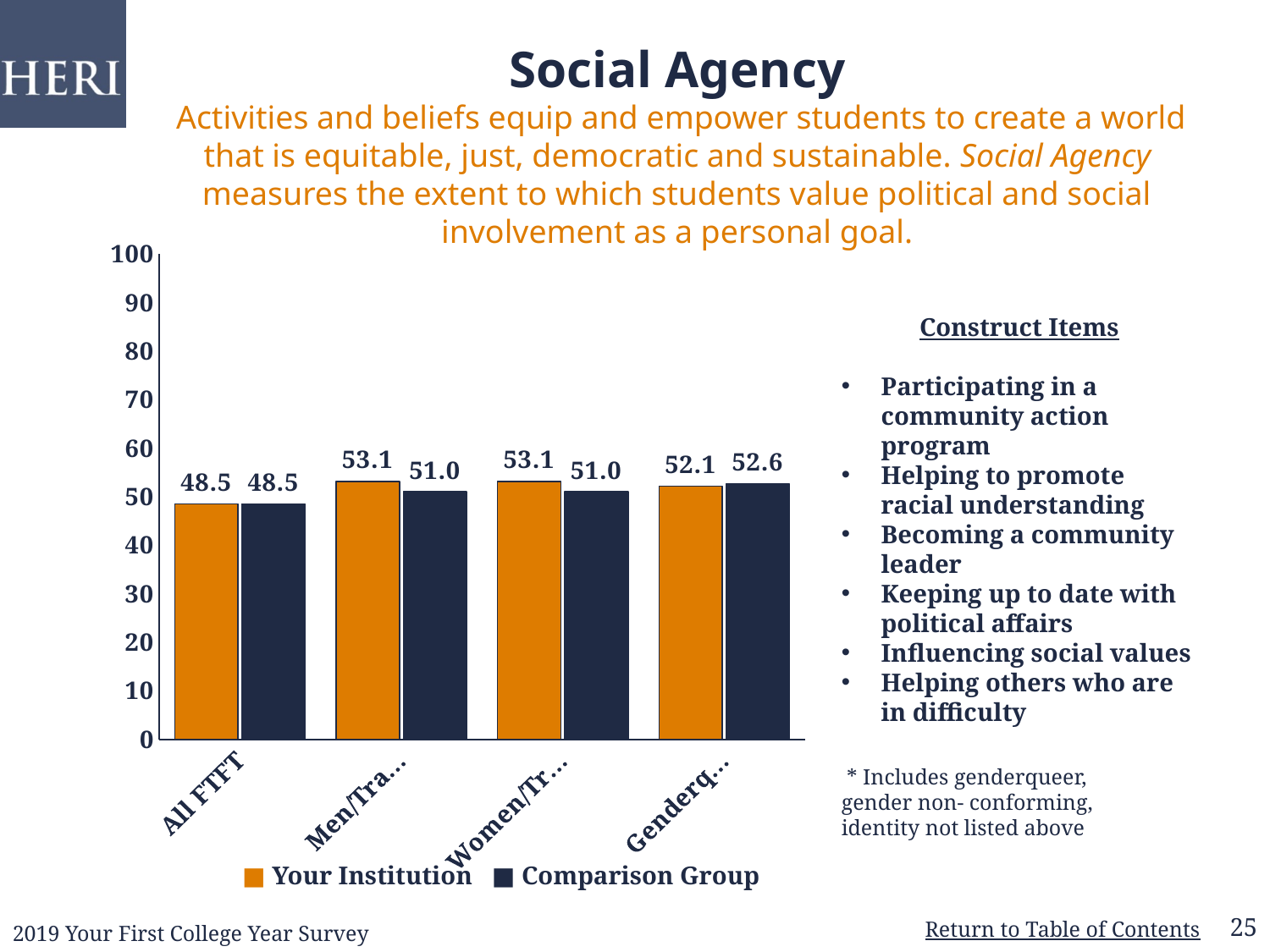
For the Genderq... category, which series has the larger value, Your Institution or Comparison Group? Comparison Group What is the Your Institution value for All FTFT? 48.5 Which category has the lowest Your Institution value? All FTFT Is the Comparison Group value for All FTFT greater or less than 50? less What is the Comparison Group value for the Women/Tr... category? 51.0 What is the difference between the Your Institution and Comparison Group values for the Men/Tra... category? 2.1 How many series does the chart legend list? 2 What is the difference between the Comparison Group and Your Institution values for the Genderq... category? 0.5 What is the Your Institution value for the Men/Tra... category? 53.1 What kind of chart is shown on the slide? bar chart What is the Comparison Group value for the Genderq... category? 52.6 How many categories are shown on the x axis of the chart? 4